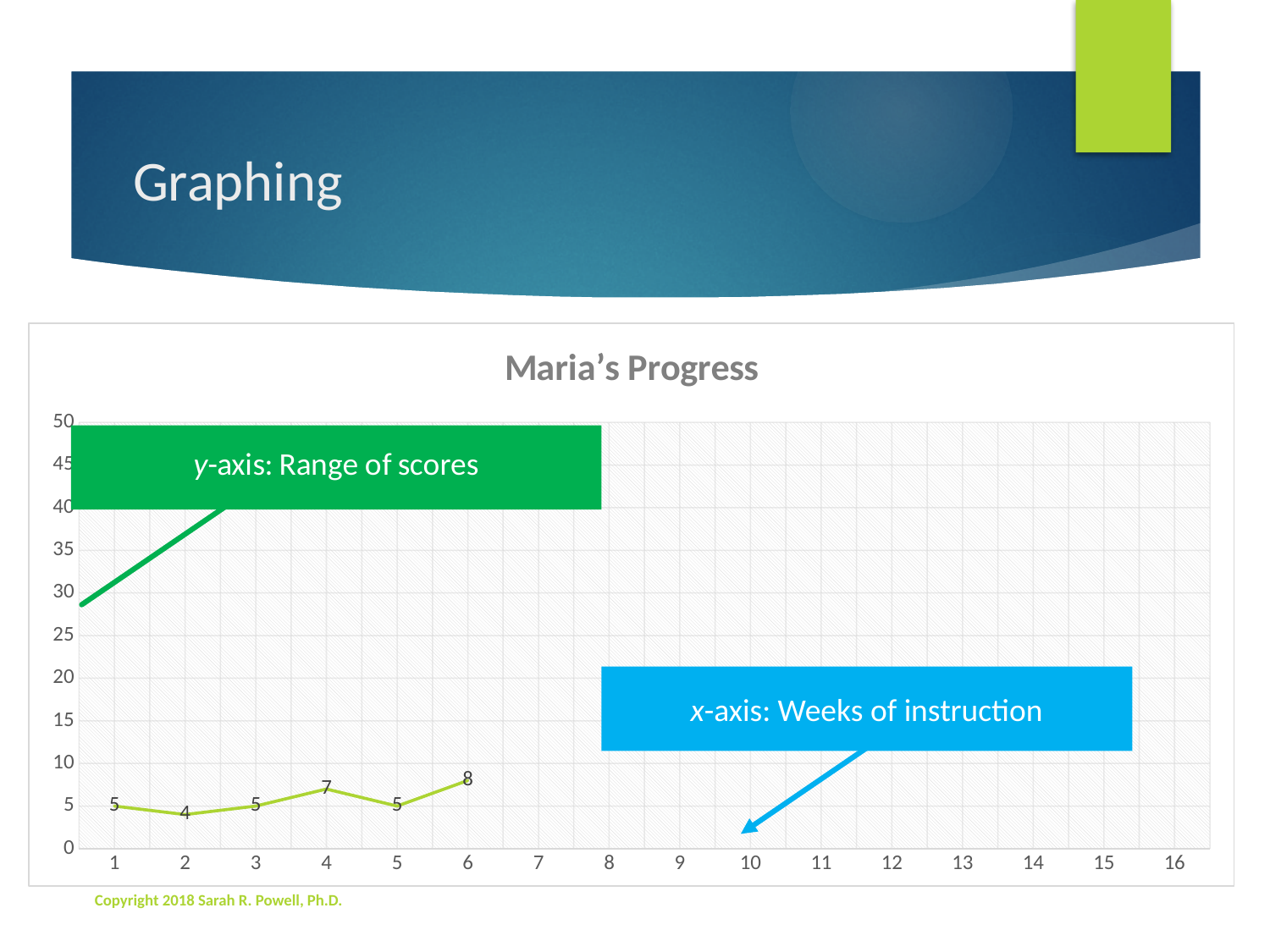
What kind of chart is shown on the slide? line chart What is Maria's score in week 4? 7 What is Maria's score in week 2? 4 What is Maria's score in week 1? 5 Which is larger, Maria's score in week 4 or her score in week 5? week 4 What is the title of the chart? Maria's Progress In which week is Maria's score the lowest? 2 What is the difference between Maria's score in week 6 and her score in week 2? 4 How many weeks have a plotted data point? 6 Is Maria's score in week 6 greater or less than 10? less What is Maria's score in week 6? 8 In which week is Maria's score the highest? 6